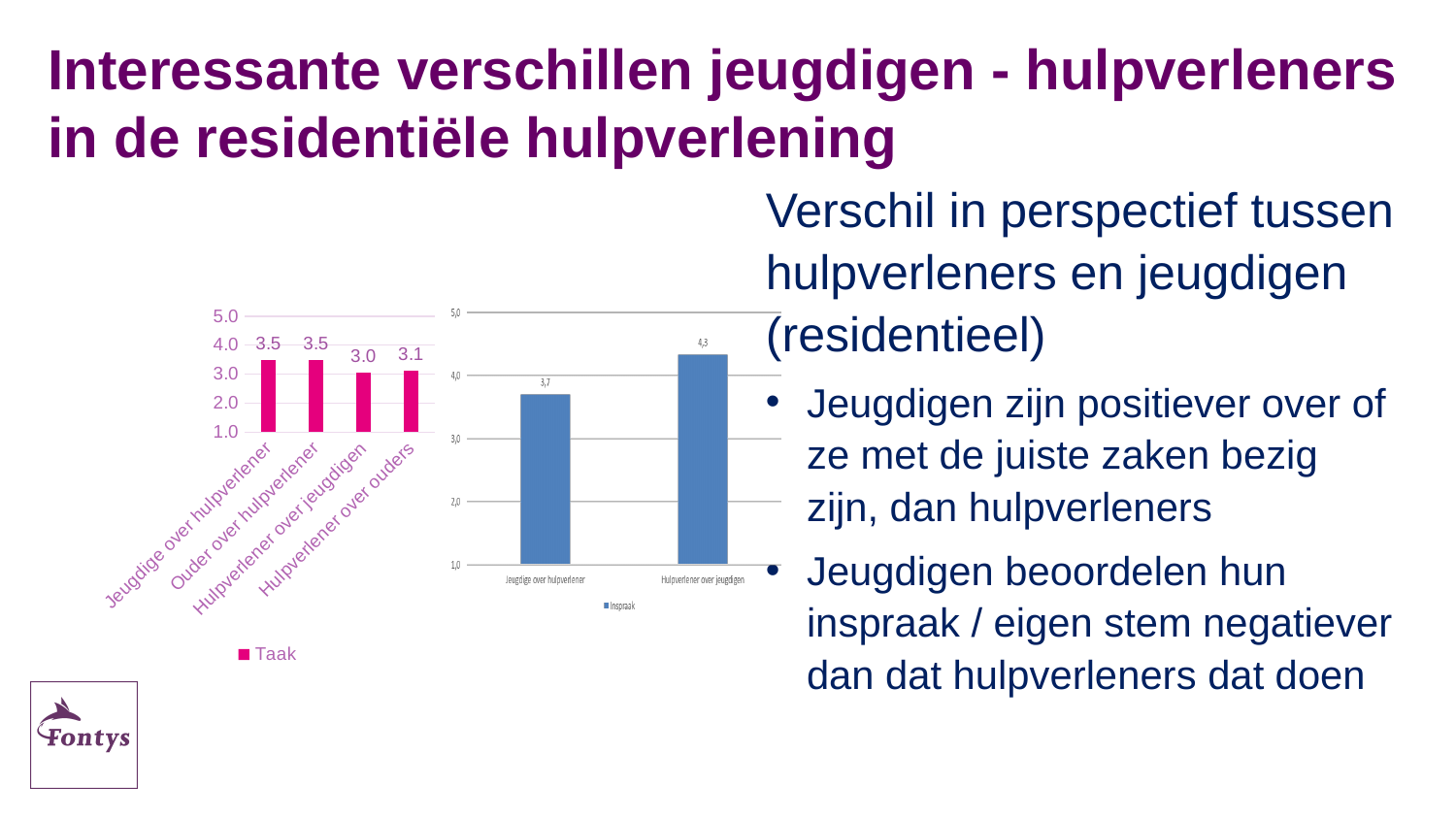
In the left chart (legend 'Taak'), what is the value for Jeugdige over hulpverlener? 3.5 In the left chart (legend 'Taak'), how many categories are shown? 4 What is the legend entry of the left chart? Taak In the left chart (legend 'Taak'), what is the value for Hulpverlener over jeugdigen? 3.0 In the right chart (legend 'Inspraak'), what is the value for Hulpverlener over jeugdigen? 4,3 In the left chart (legend 'Taak'), what is the difference between Jeugdige over hulpverlener and Hulpverlener over jeugdigen? 0.5 In the right chart (legend 'Inspraak'), what is the difference between Hulpverlener over jeugdigen and Jeugdige over hulpverlener? 0,6 In the right chart (legend 'Inspraak'), what is the value for Jeugdige over hulpverlener? 3,7 In the right chart (legend 'Inspraak'), which category has the highest value? Hulpverlener over jeugdigen What kind of chart is the right chart (legend 'Inspraak')? Bar chart In the left chart (legend 'Taak'), what is the value for Hulpverlener over ouders? 3.1 In the left chart (legend 'Taak'), which category has the lowest value? Hulpverlener over jeugdigen